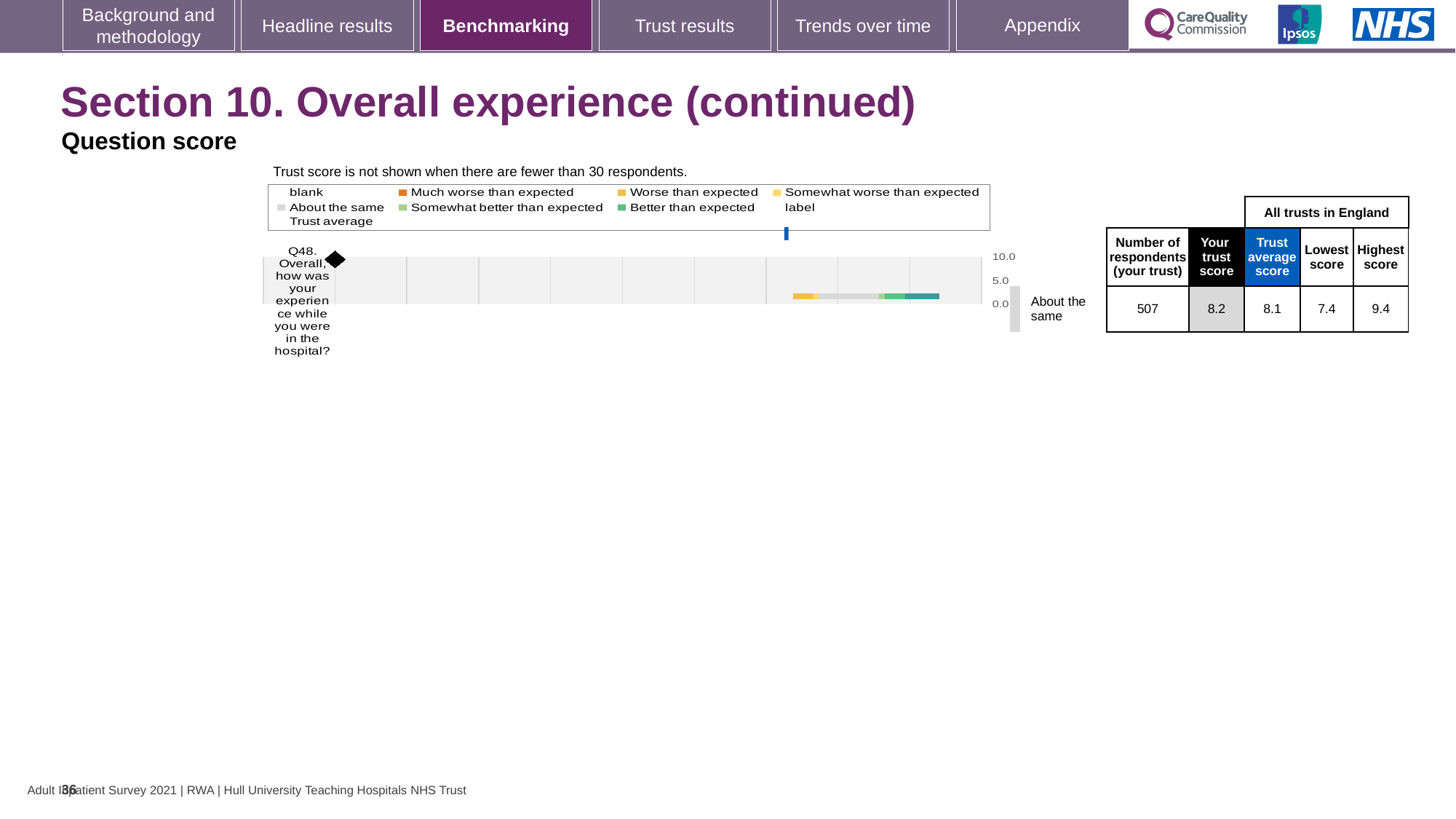
What is the trust average score across all trusts in England for Q48? 8.1 What is the trust score for Q48 (Overall, how was your experience while you were in the hospital?)? 8.2 Which is larger for Q48: the trust's own score or the trust average score? Your trust score What is the highest score among all trusts in England for Q48? 9.4 What is the lowest score among all trusts in England for Q48? 7.4 What is the difference between the highest and lowest scores across all trusts in England for Q48? 2.0 Is the trust score for Q48 greater or less than 5.0? greater How many questions are plotted on the chart? 1 What benchmark category is the trust's Q48 score assigned to? About the same What is the maximum value shown on the chart's score axis? 10.0 How many respondents from the trust answered Q48? 507 What kind of chart is used to show the Q48 benchmarking result? bar chart